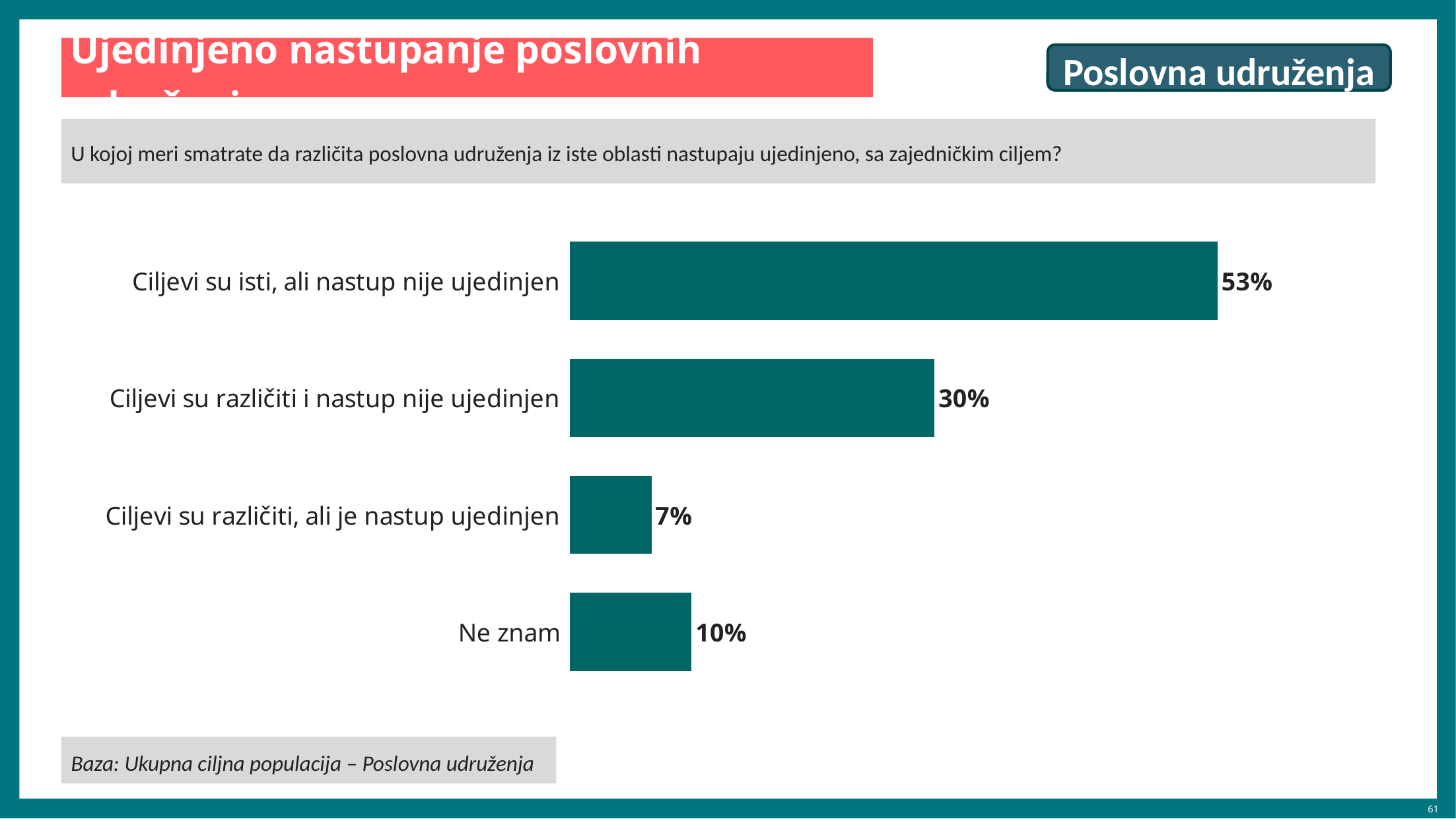
What kind of chart is shown on the slide? Bar chart What is the difference between the values for "Ciljevi su isti, ali nastup nije ujedinjen" and "Ciljevi su različiti i nastup nije ujedinjen"? 23% Which category has the highest value? Ciljevi su isti, ali nastup nije ujedinjen Which is larger, the value for "Ne znam" or the value for "Ciljevi su različiti, ali je nastup ujedinjen"? Ne znam What is the value for "Ciljevi su isti, ali nastup nije ujedinjen"? 53% What is the value for "Ne znam"? 10% Which category has the lowest value? Ciljevi su različiti, ali je nastup ujedinjen What colour are the bars in the chart? Dark teal What is the value for "Ciljevi su različiti i nastup nije ujedinjen"? 30% What is the difference between the values for "Ne znam" and "Ciljevi su različiti, ali je nastup ujedinjen"? 3% What is the value for "Ciljevi su različiti, ali je nastup ujedinjen"? 7% How many categories are shown in the chart? 4